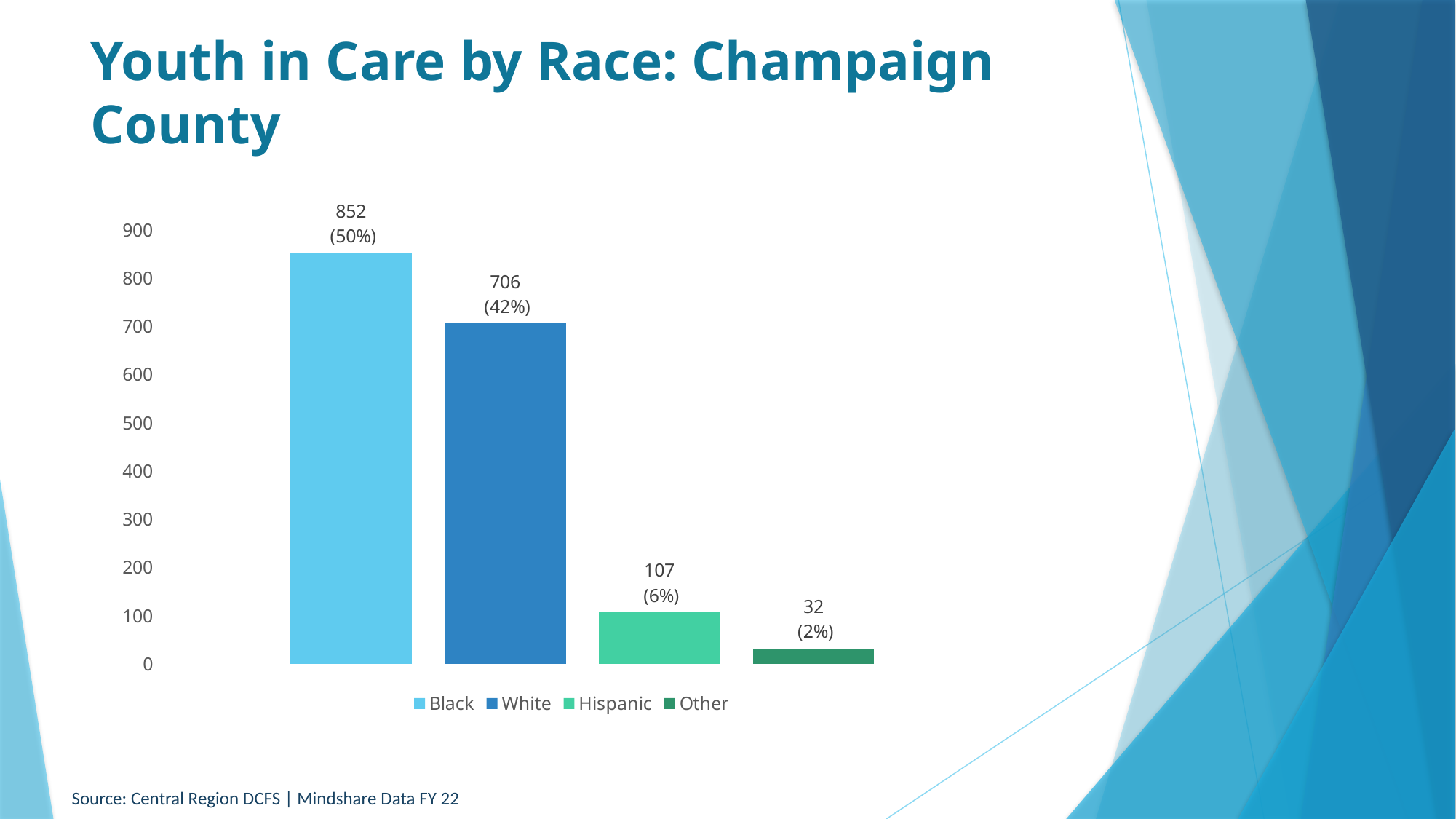
What kind of chart is shown on the slide? Bar chart Which category has the lowest number of youth in care? Other What is the source cited for the chart data? Central Region DCFS | Mindshare Data FY 22 What percentage of youth in care are in the Other category? 2% How many youth in care are Black? 852 What is the difference between the Black and White values? 146 What is the value for Hispanic? 107 Which is larger, the value for Hispanic or the value for Other? Hispanic How many categories are shown in the chart? 4 Which category has the highest number of youth in care? Black Is the value for White greater or less than 600? greater What is the value for White? 706